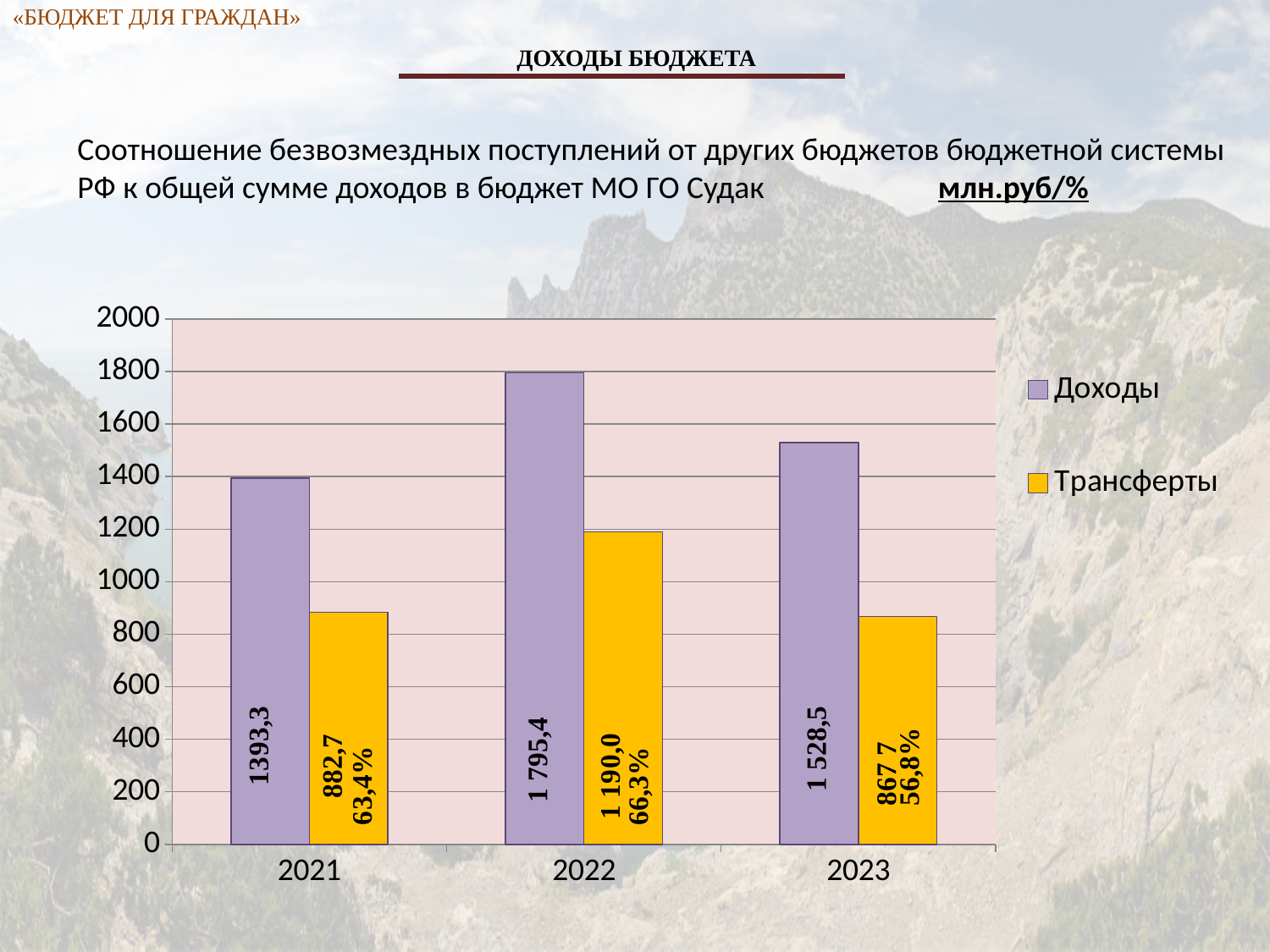
How many series does the legend list? 2 What is the value of Трансферты for 2021? 882,7 What kind of chart is shown on the slide? bar chart How many years are shown on the x axis? 3 In which year is Трансферты lowest? 2023 What is the value of Доходы for 2023? 1 528,5 Is the value of Трансферты for 2022 greater or less than 1000? greater What is the difference between Доходы and Трансферты in 2021? 510,6 Which is larger in 2023: Доходы or Трансферты? Доходы What percentage is shown on the Трансферты bar for 2022? 66,3% In which year is Доходы highest? 2022 What is the value of Доходы for 2022? 1 795,4